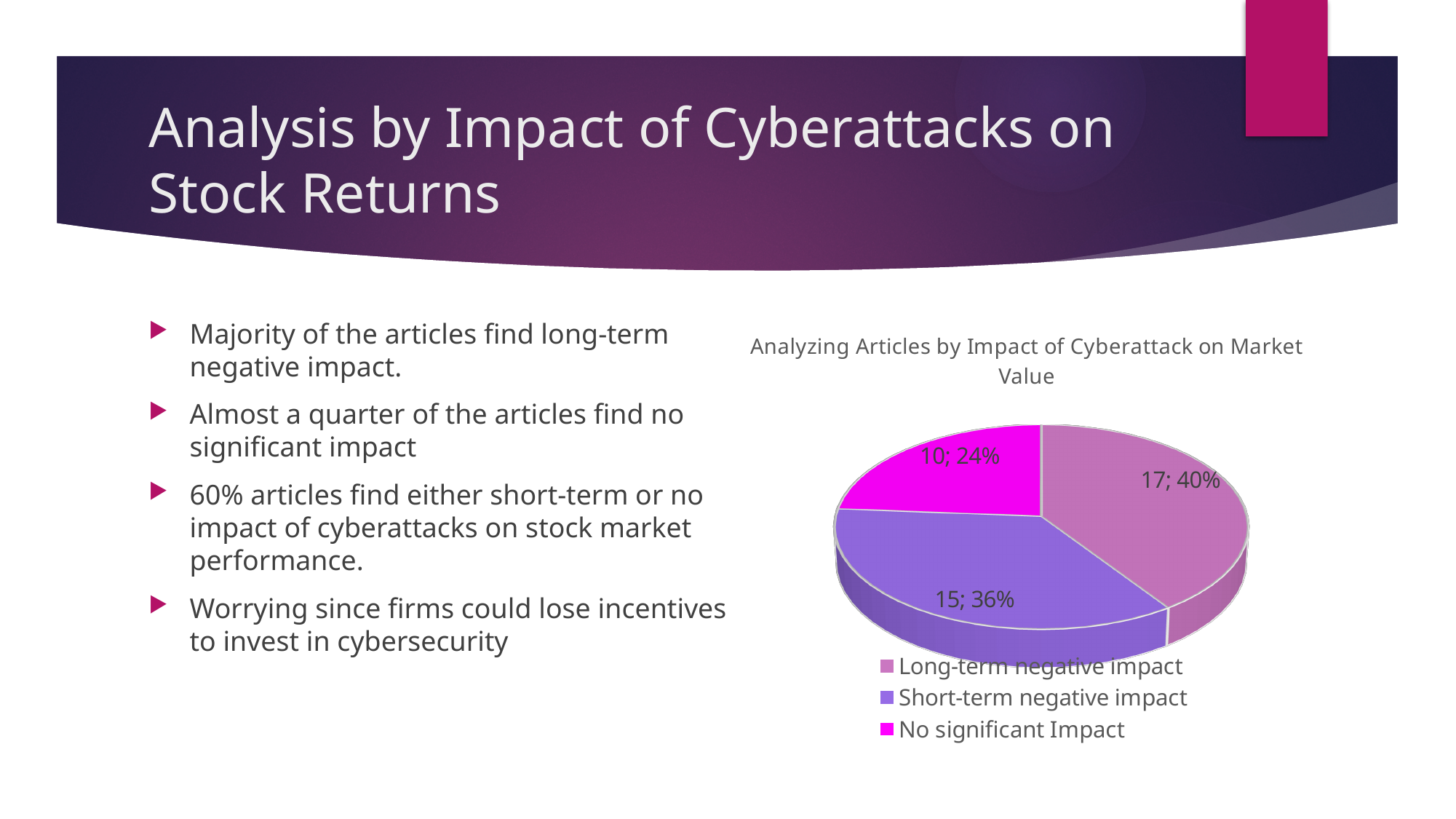
How many slices does the pie chart have? 3 What percentage of the pie is the Short-term negative impact slice? 36% How many articles are in the No significant Impact slice? 10 What is the total number of articles across all three slices? 42 What type of chart is shown on the slide? Pie chart Which category has the smallest slice of the pie? No significant Impact What percentage of the pie is the Long-term negative impact slice? 40% Which category has the largest slice of the pie? Long-term negative impact Which has more articles, Short-term negative impact or No significant Impact? Short-term negative impact What is the title of the chart? Analyzing Articles by Impact of Cyberattack on Market Value What is the difference in article count between Long-term negative impact and No significant Impact? 7 How many articles are in the Long-term negative impact slice? 17